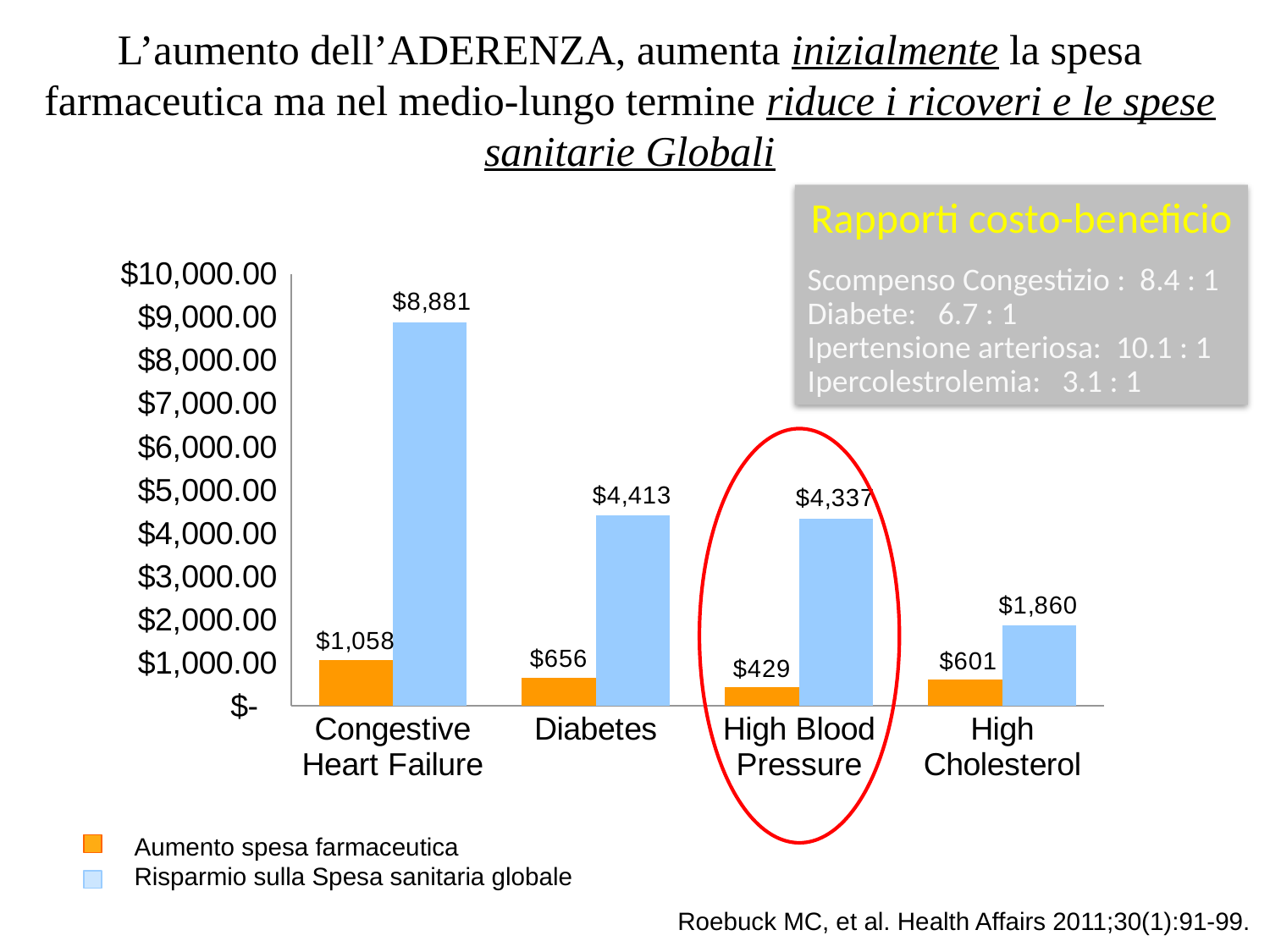
Which category has the lowest 'Aumento spesa farmaceutica' value? High Blood Pressure How many categories are shown on the x axis? 4 What kind of chart is shown on the slide? Bar chart What is the value of 'Risparmio sulla Spesa sanitaria globale' for Congestive Heart Failure? $8,881 How many series does the legend list? 2 What is the value of 'Risparmio sulla Spesa sanitaria globale' for Diabetes? $4,413 Which category is circled in red on the chart? High Blood Pressure What is the value of 'Aumento spesa farmaceutica' for High Cholesterol? $601 Which is larger: 'Aumento spesa farmaceutica' for Congestive Heart Failure or for Diabetes? Congestive Heart Failure What is the difference between 'Risparmio sulla Spesa sanitaria globale' and 'Aumento spesa farmaceutica' for Diabetes? $3,757 What is the value of 'Aumento spesa farmaceutica' for High Blood Pressure? $429 Which category has the highest 'Risparmio sulla Spesa sanitaria globale' value? Congestive Heart Failure